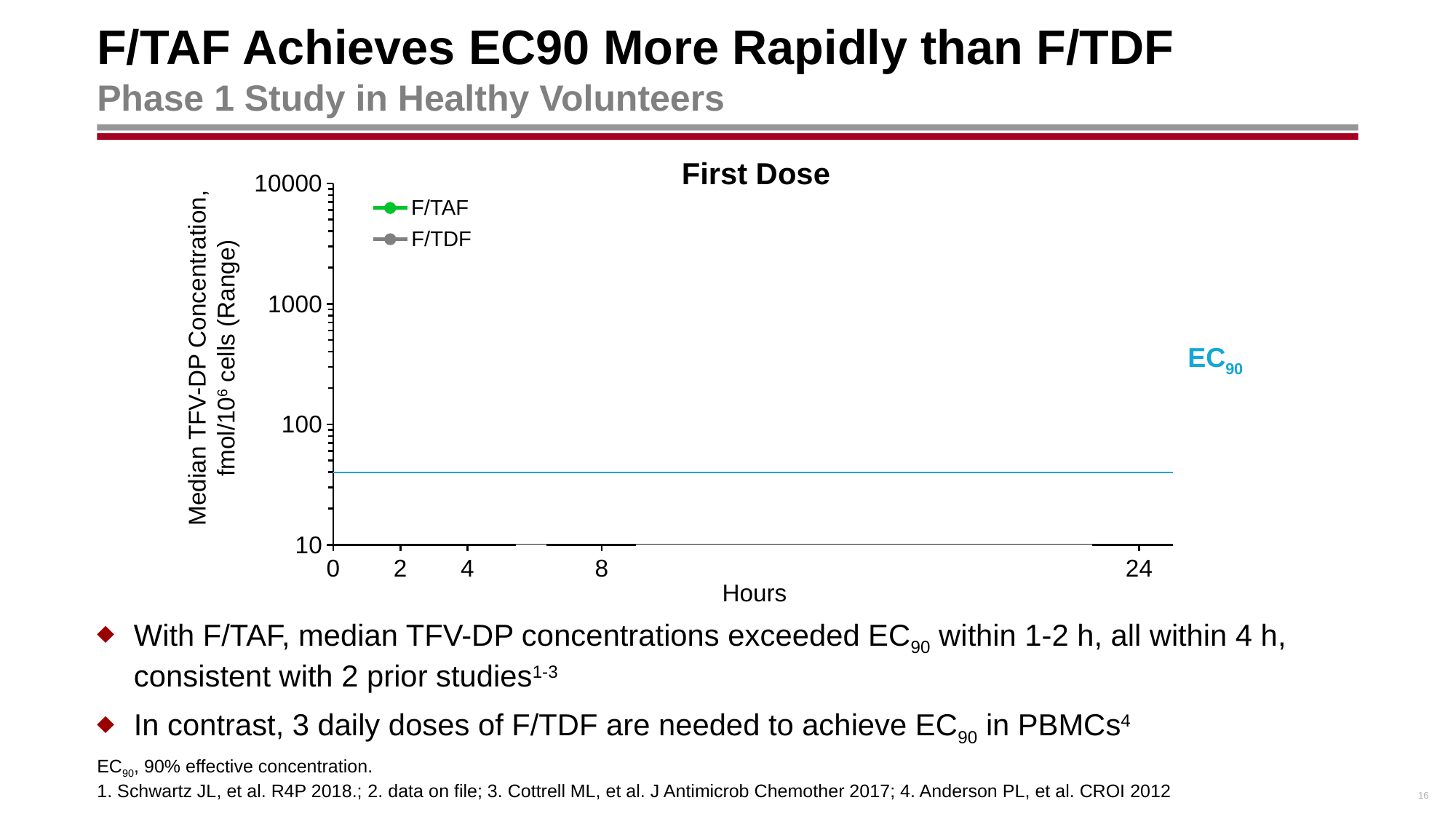
What label is shown on the x axis of the chart? Hours What is the largest hour value labelled on the x axis of the chart? 24 What is the title of the chart? First Dose How many tick labels are shown on the x axis of the chart? 5 Is the EC90 reference line on the chart greater or less than 10? greater Is the EC90 reference line on the chart greater or less than 100? less What is the lowest value labelled on the y axis of the chart? 10 What is the highest value labelled on the y axis of the chart? 10000 How many series does the legend of the First Dose chart list? 2 What kind of chart is shown on the slide? line chart